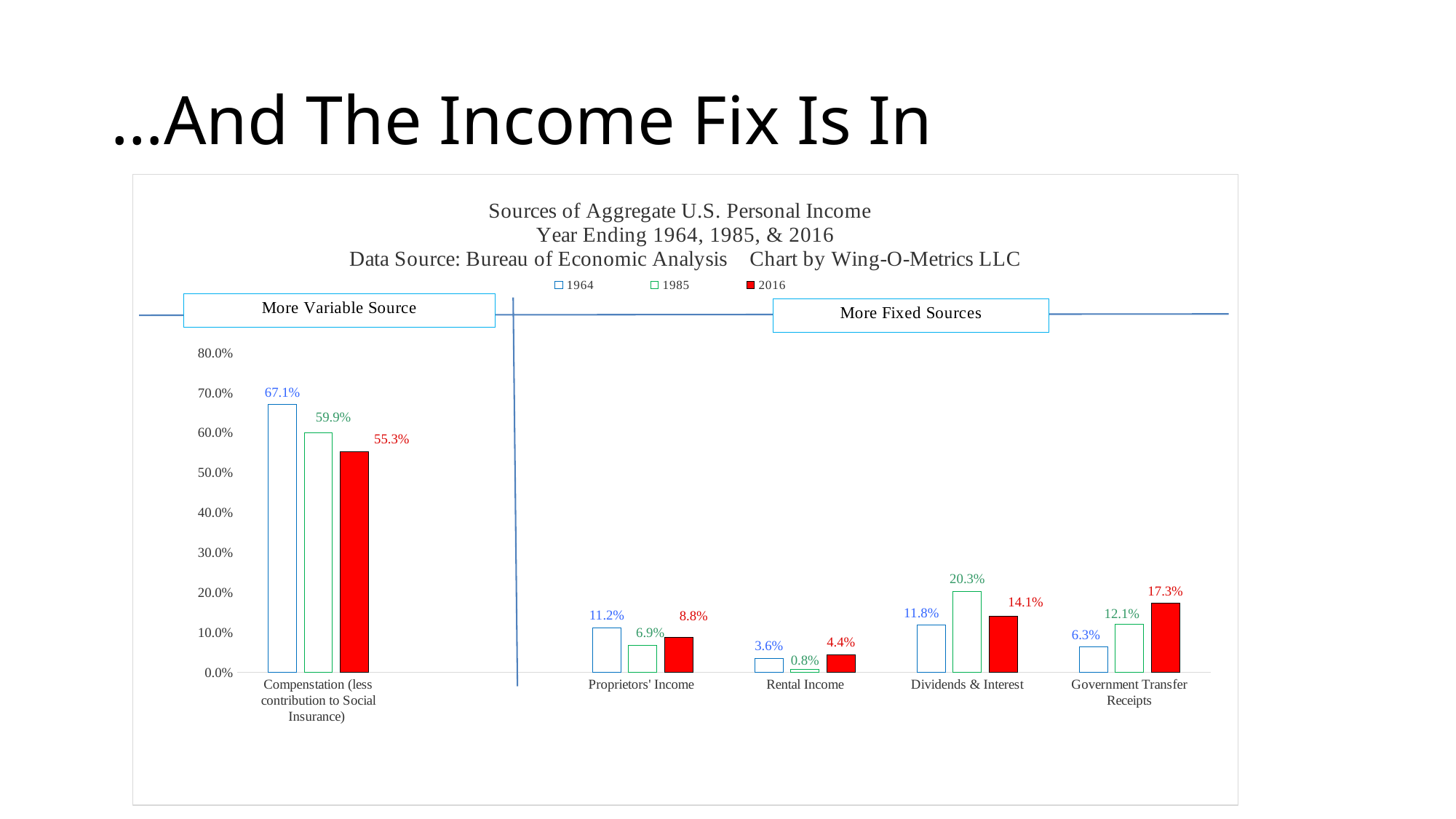
What is the 2016 value for Compensation (less contribution to Social Insurance)? 55.3% What is the difference between the 1964 and 2016 values for Compensation (less contribution to Social Insurance)? 11.8% What is the 2016 value for Government Transfer Receipts? 17.3% Which is larger for Proprietors' Income, the 1964 value or the 2016 value? 1964 Do the values for Government Transfer Receipts rise or fall from 1964 to 2016? Rise What kind of chart is shown on the slide? Bar chart What is the 1985 value for Dividends & Interest? 20.3% Which category has the highest 1964 value? Compensation (less contribution to Social Insurance) How many categories are shown on the x axis? 5 What is the 1964 value for Rental Income? 3.6% Which category has the lowest 1985 value? Rental Income How many series does the legend list? 3